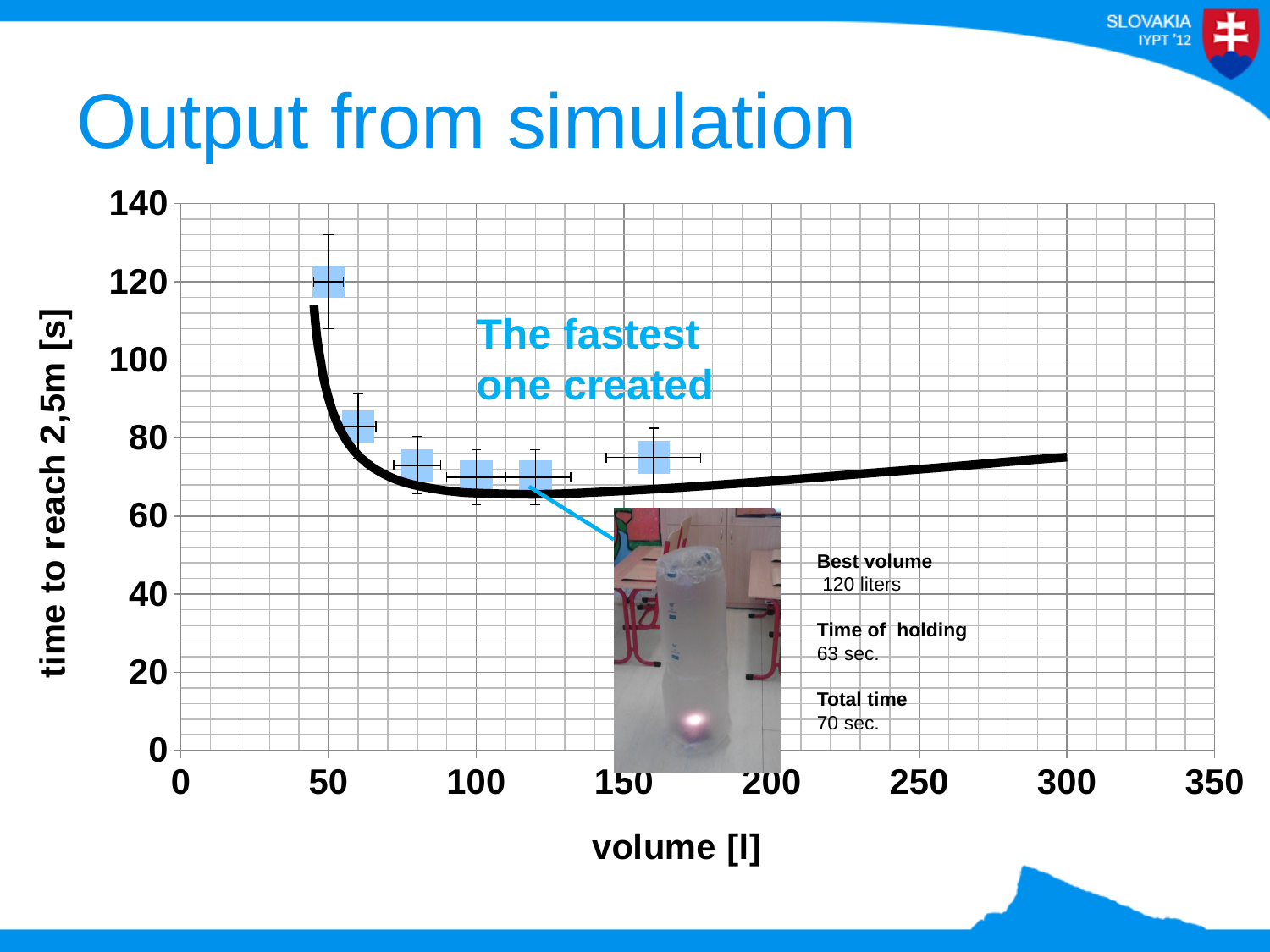
How does the time to reach 2,5 m change as the volume increases from 50 l to about 120 l? It falls Is the time for the data point at a volume of about 160 l greater or less than 100 s? less What is the maximum value shown on the y axis? 140 How many measured data points (blue squares) are plotted on the chart? 6 What is the label of the y axis? time to reach 2,5m [s] At which volume is the highest measured time to reach 2,5 m found? 50 l What kind of chart is shown on the slide? Scatter plot with a fitted curve Is the time for the data point at a volume of about 80 l greater or less than 60 s? greater What is the label of the x axis? volume [l] Which data point has the highest time to reach 2,5 m: the one at about 50 l or the one at about 160 l? The one at about 50 l Is the time for the data point at a volume of about 50 l greater or less than 100 s? greater According to the fitted curve, does the time rise or fall as the volume increases from 150 l to 300 l? It rises